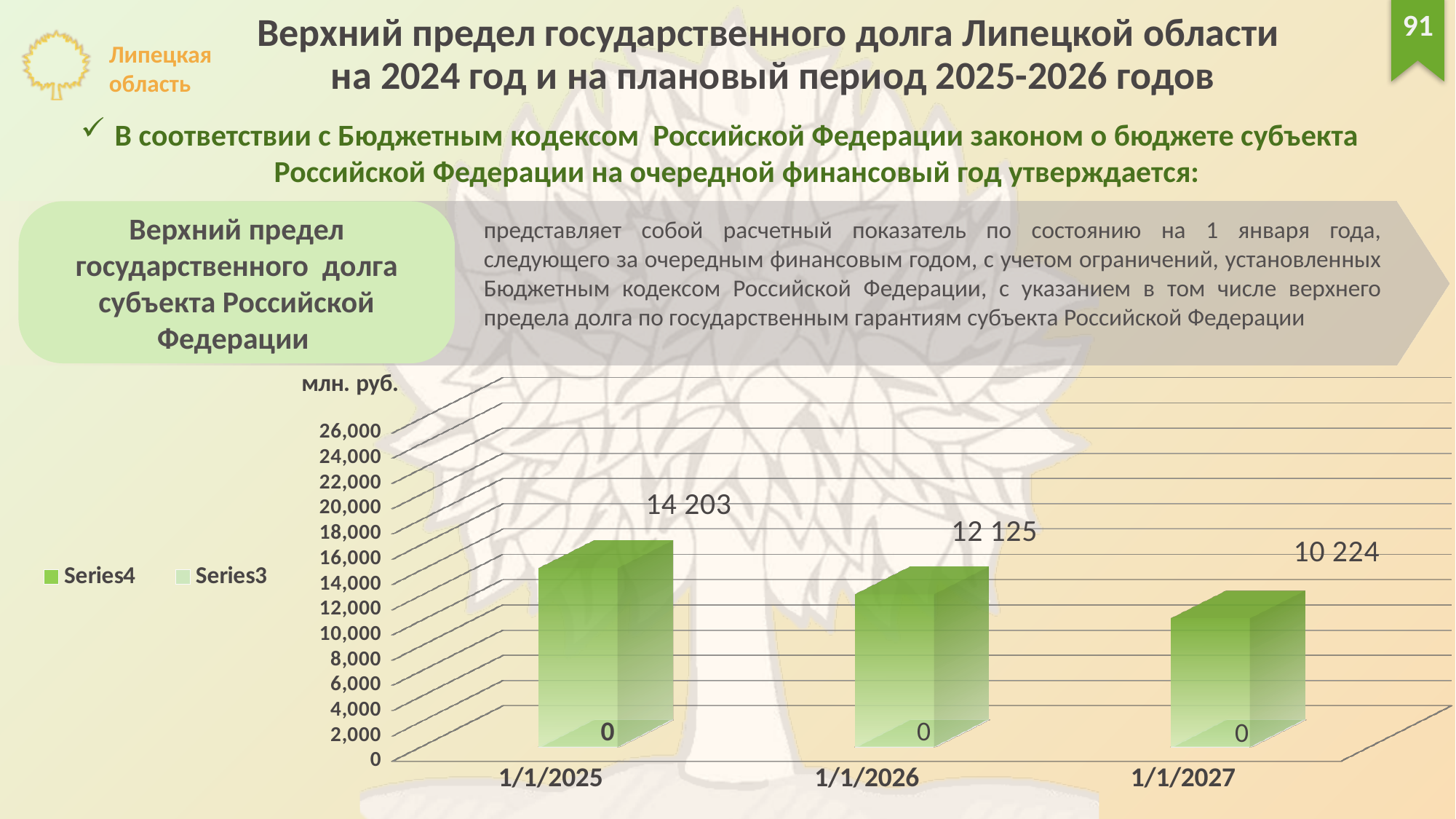
What is the difference between the values for 1/1/2026 and 1/1/2027? 1 901 What is the value shown for 1/1/2026 on the chart? 12 125 Do the values rise or fall from 1/1/2025 to 1/1/2027? Fall What is the value shown for 1/1/2027 on the chart? 10 224 How many series does the chart legend list? 2 How many dates are shown on the x axis of the chart? 3 Which date has the highest value on the chart? 1/1/2025 What type of chart is shown on the slide? Bar chart What is the value shown for 1/1/2025 on the chart? 14 203 Which is larger, the value for 1/1/2025 or the value for 1/1/2027? 1/1/2025 Which date has the lowest non-zero value on the chart? 1/1/2027 What is the difference between the values for 1/1/2025 and 1/1/2026? 2 078